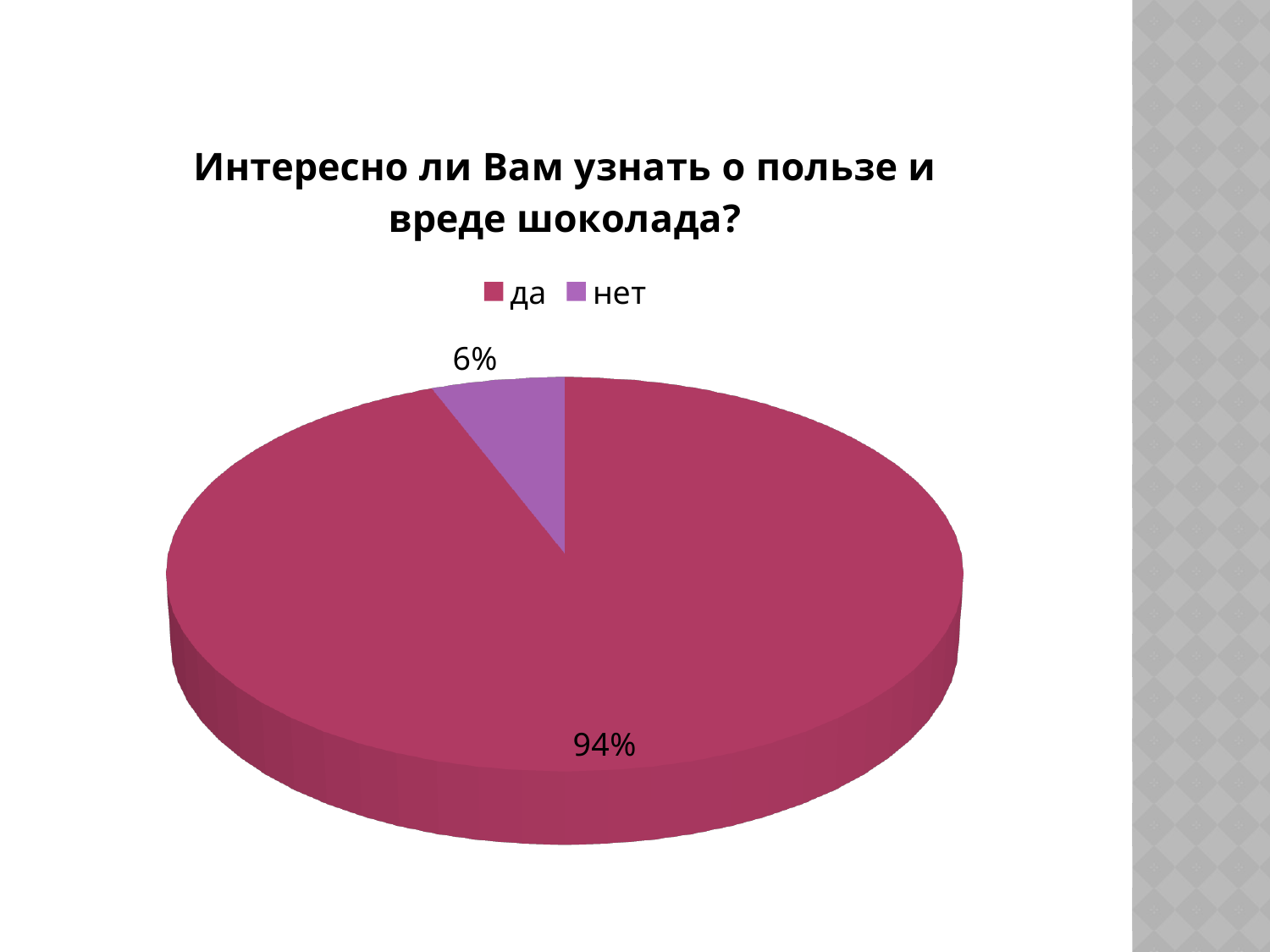
Which category has the largest slice? да Which is larger, the slice for "да" or the slice for "нет"? да What is the difference in percentage points between "да" and "нет"? 88 How many entries does the legend list? 2 What share of the pie does "да" take? 94% Which legend entry is shown in purple? нет What share of the pie does "нет" take? 6% Which category has the smallest slice? нет How many slices does the pie chart have? 2 What kind of chart is shown on the slide? pie chart What is the title of the chart? Интересно ли Вам узнать о пользе и вреде шоколада?